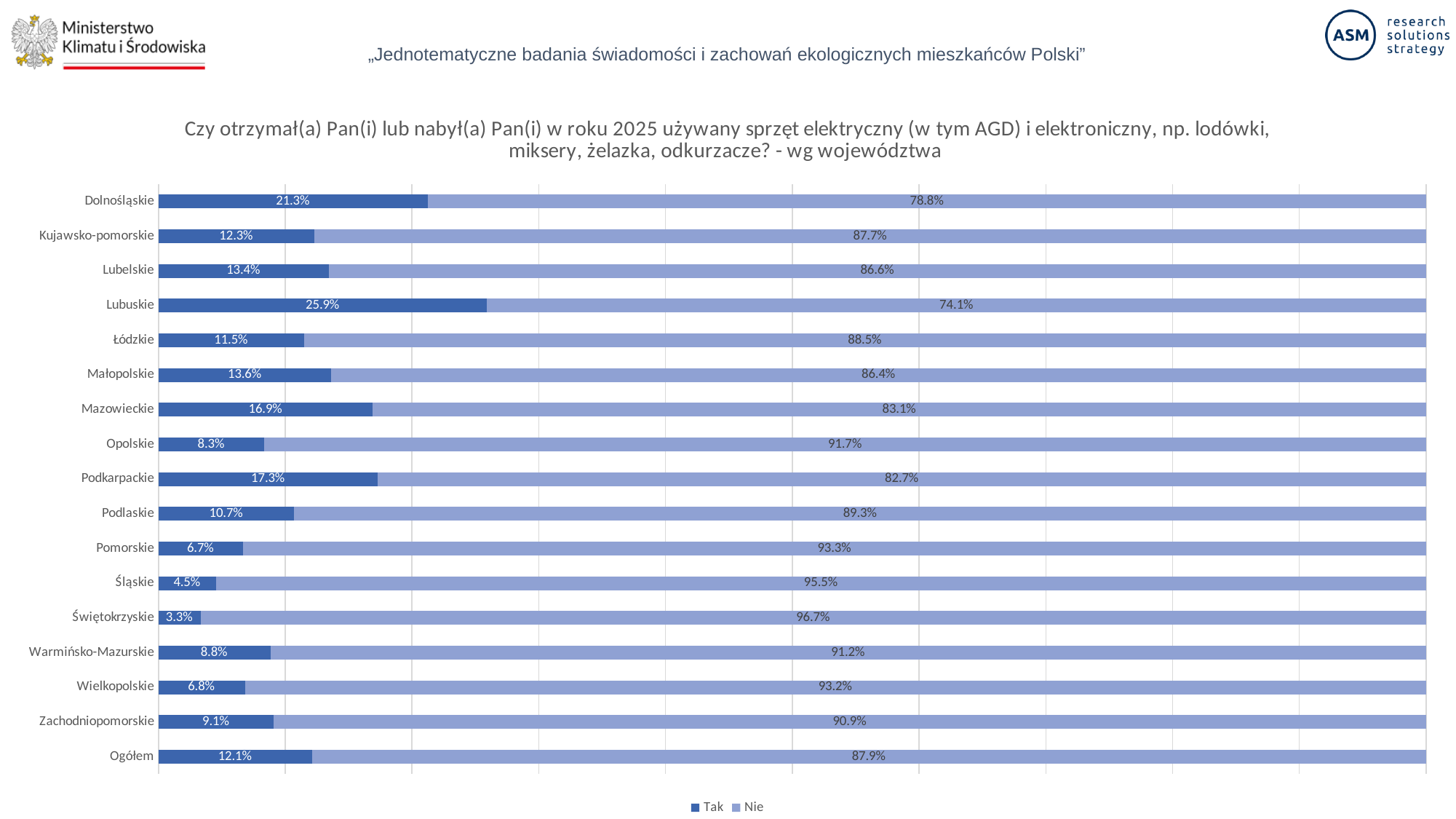
Which voivodeship has the highest 'Tak' value? Lubuskie What kind of chart is shown on the slide? Stacked bar chart Which has a larger 'Tak' value, Mazowieckie or Podkarpackie? Podkarpackie What is the total of the 'Tak' and 'Nie' values for Śląskie? 100.0% What is the 'Nie' value for Opolskie? 91.7% What is the difference between the 'Tak' values for Dolnośląskie and Kujawsko-pomorskie? 9.0% What are the two series named in the legend? Tak and Nie How many categories (rows) are shown on the chart? 17 How many series does the legend list? 2 What is the 'Tak' value for Lubuskie? 25.9% What is the 'Tak' value for Ogółem? 12.1% Which voivodeship has the lowest 'Tak' value? Świętokrzyskie